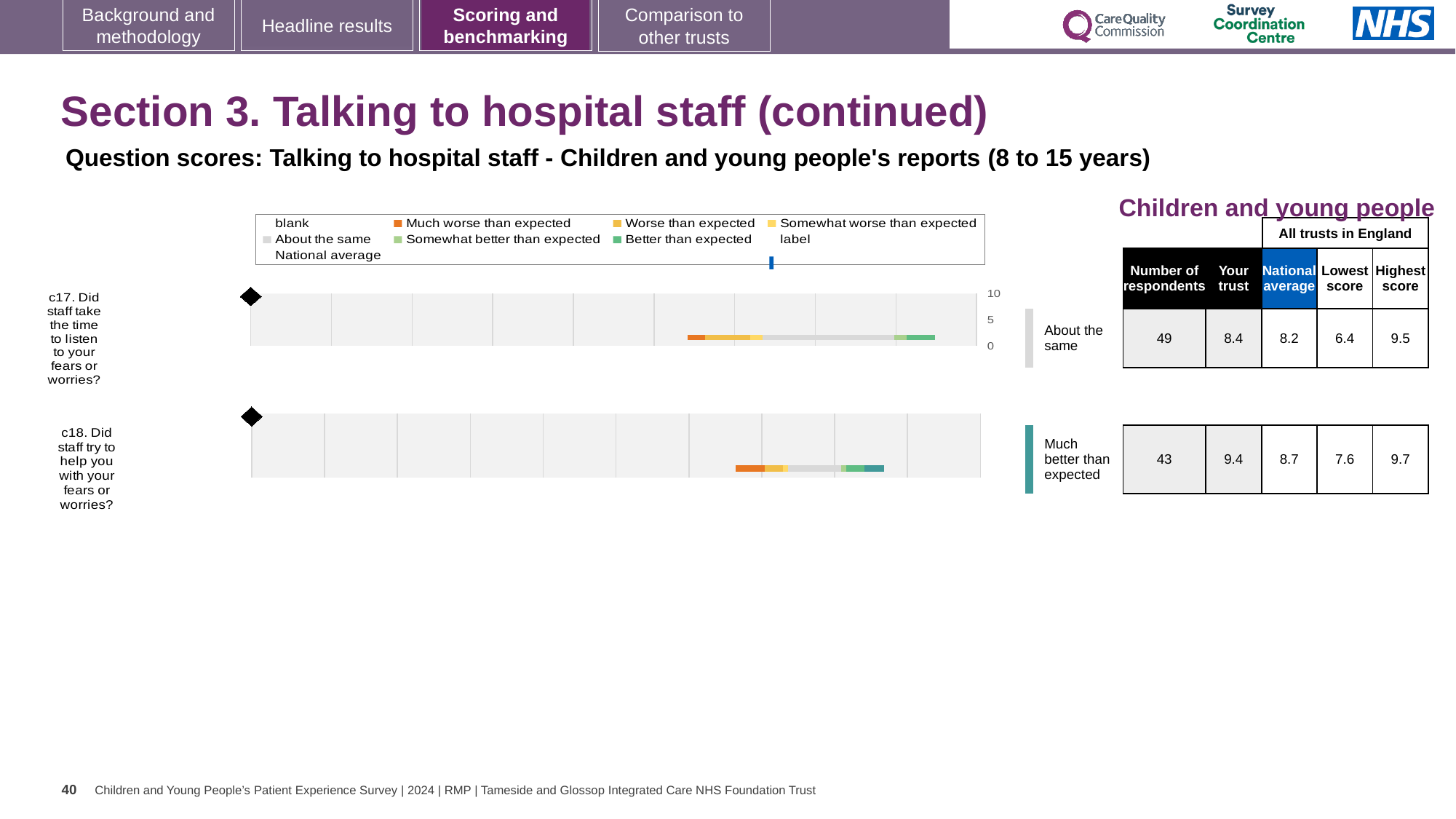
How many questions are plotted on this slide? 2 What benchmark category is shown for question c18? Much better than expected What is the national average score for question c17? 8.2 How many respondents answered question c18? 43 What kind of chart is used to show the question scores on this slide? Bar chart What is the 'Your trust' score for question c18 (Did staff try to help you with your fears or worries?)? 9.4 What is the 'Your trust' score for question c17 (Did staff take the time to listen to your fears or worries?)? 8.4 How many respondents answered question c17? 49 What is the highest score across all trusts in England for question c18? 9.7 What is the lowest score across all trusts in England for question c17? 6.4 Which question has the higher 'Your trust' score, c17 or c18? c18 For question c18, how much higher is the trust's score than the national average? 0.7